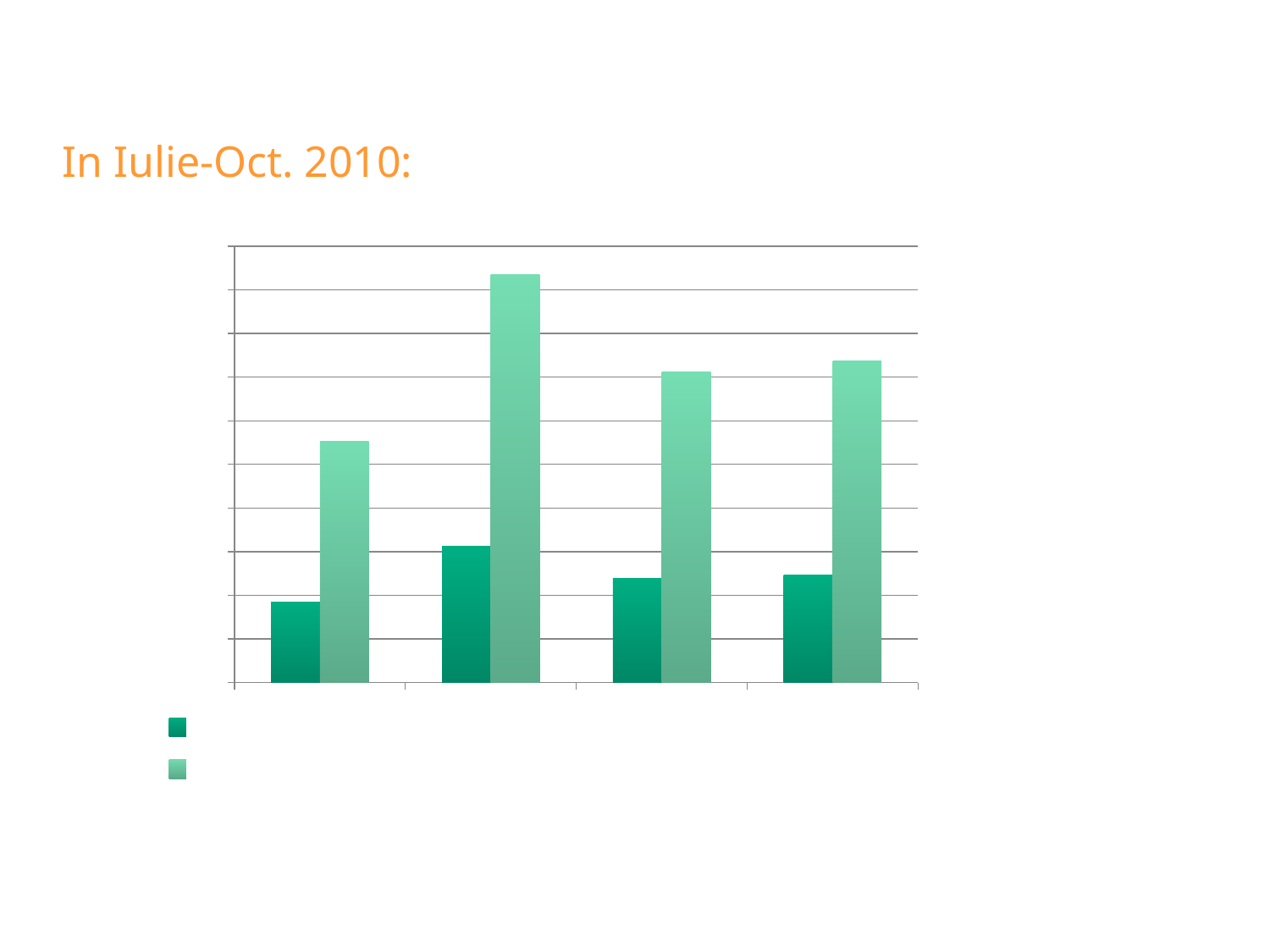
Which group of bars, counting from the left, contains the tallest bar in the chart? the second group How many groups of bars are plotted along the x axis? 4 Which group of bars, counting from the left, contains the shortest bar in the chart? the first group What kind of chart is shown on the slide? bar chart Are the bars in the chart vertical or horizontal? vertical In every group, is the light green bar taller or shorter than the dark green bar? taller How many series does the legend list? 2 What colours are the two series in the chart? dark green and light green